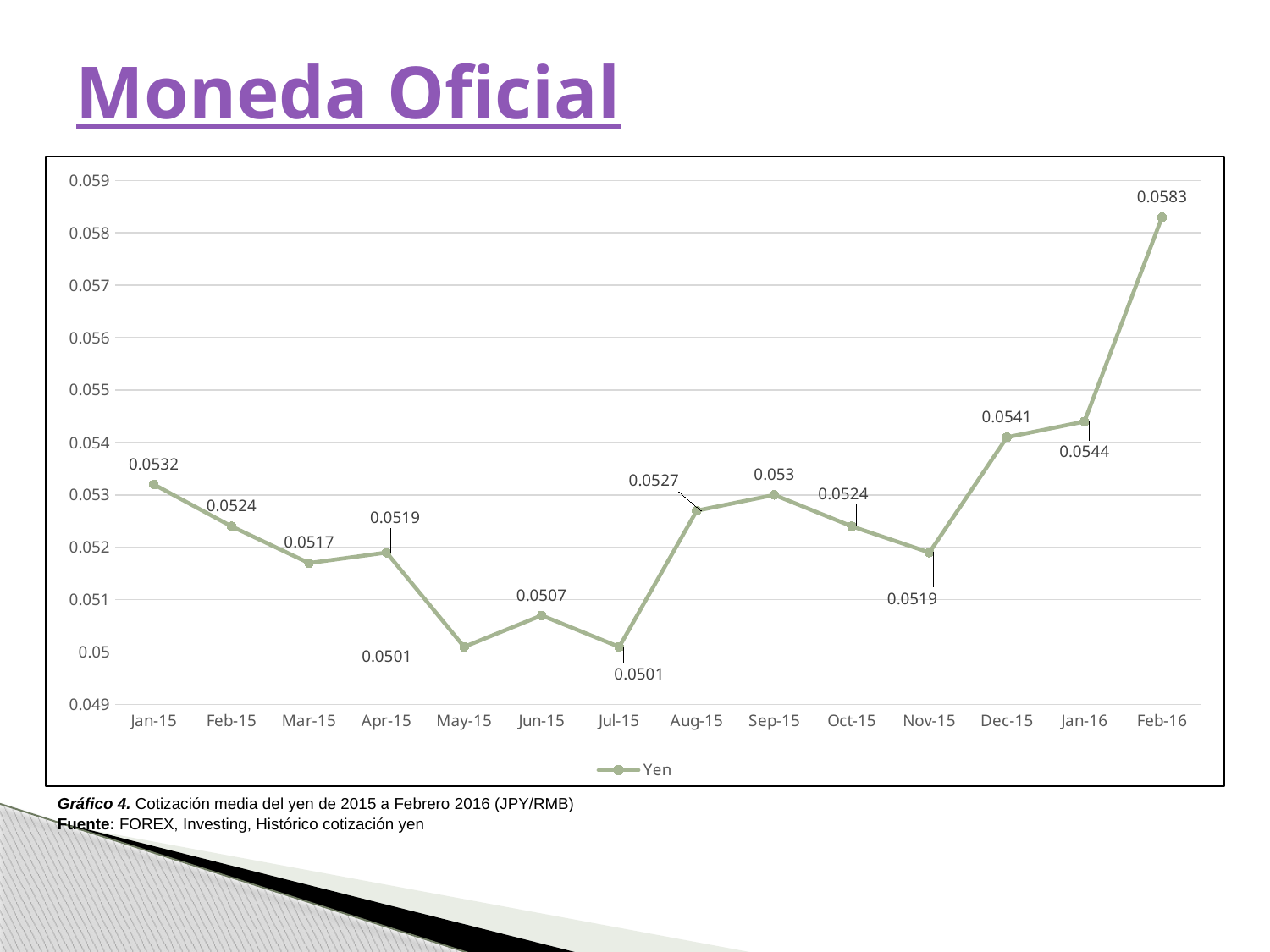
What is the difference between the Yen value in Aug-15 and in Jul-15? 0.0026 What is the value for Yen in Nov-15? 0.0519 What is the value for Yen in Jan-15? 0.0532 What is the value for Yen in Feb-16? 0.0583 How many series does the legend list? 1 What is the value for Yen in Sep-15? 0.053 In which month is the Yen value highest? Feb-16 What kind of chart is shown on the slide? line chart Is the Yen value in Jan-16 greater or less than 0.055? less Which is larger, the Yen value in Dec-15 or in Oct-15? Dec-15 How many months are plotted on the x axis? 14 What is the difference between the Yen value in Feb-16 and in Jan-15? 0.0051